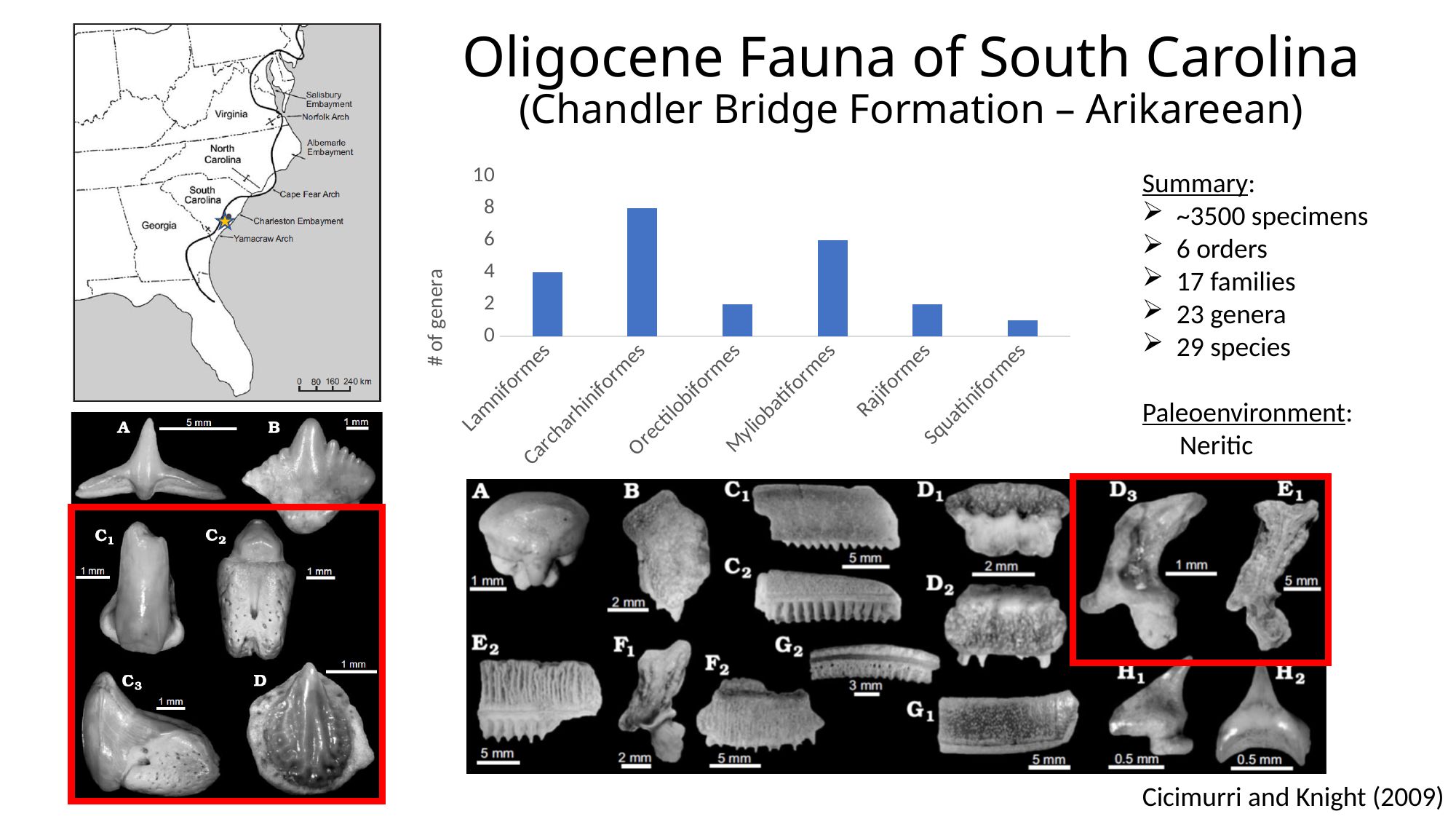
What is the difference in number of genera between Carcharhiniformes and Myliobatiformes? 2 Which order has the lowest number of genera in the chart? Squatiniformes How many genera does the chart show for Myliobatiformes? 6 What kind of chart is shown on the slide? bar chart Which order has the highest number of genera in the chart? Carcharhiniformes Which has more genera, Lamniformes or Myliobatiformes? Myliobatiformes How many categories (orders) are shown on the x axis of the chart? 6 What is the label on the y axis of the chart? # of genera How many genera does the chart show for Rajiformes? 2 How many genera does the chart show for Lamniformes? 4 How many genera does the chart show for Carcharhiniformes? 8 Is the value for Squatiniformes greater or less than 2? less